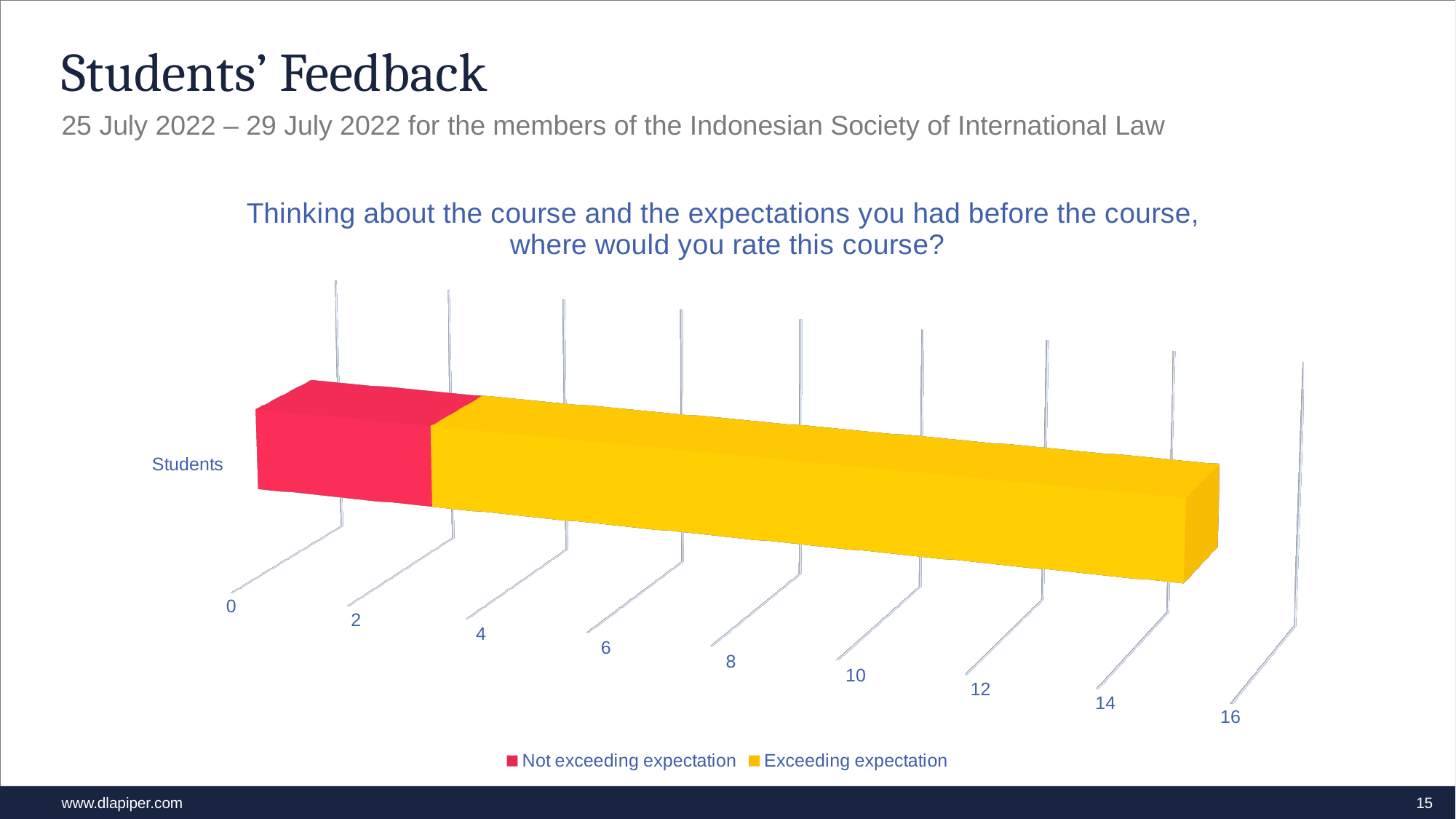
Is the value for Not exceeding expectation greater or less than 4? less How many series does the legend list? 2 What colour represents the Exceeding expectation series? yellow Is the value for Exceeding expectation greater or less than 10? greater Is the total of the stacked bar for Students greater or less than 12? greater What is the name of the single category plotted on the chart? Students How many categories are plotted on the chart? 1 Which series is larger for Students: Not exceeding expectation or Exceeding expectation? Exceeding expectation Which series has the lowest value for Students? Not exceeding expectation What kind of chart is shown on the slide? bar chart Which series has the highest value for Students? Exceeding expectation